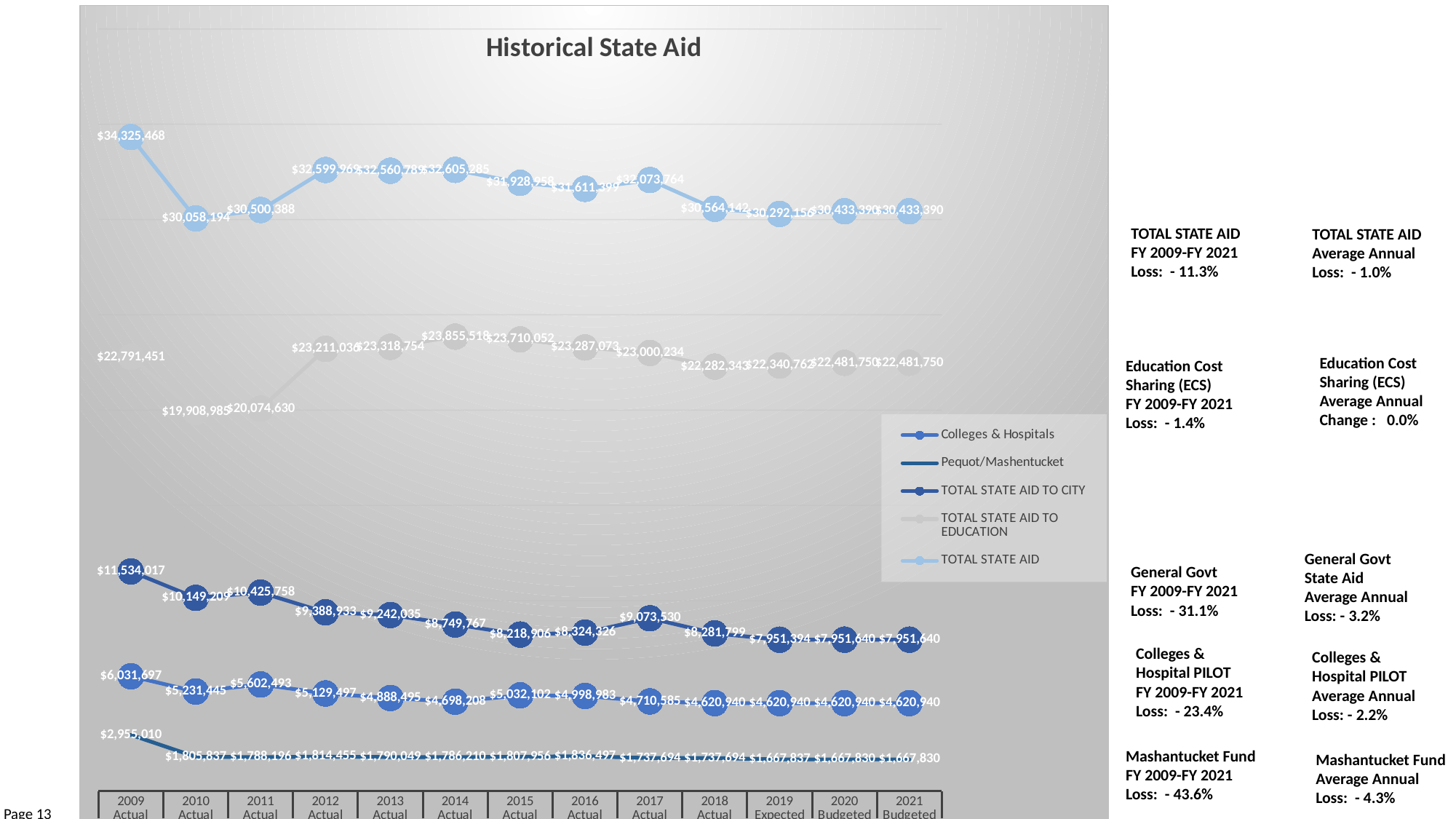
What is the title of the chart? Historical State Aid Which is larger for 2010 Actual: TOTAL STATE AID TO CITY or Colleges & Hospitals? TOTAL STATE AID TO CITY What is the Pequot/Mashentucket value for 2009 Actual? $2,955,010 What is the Colleges & Hospitals value for 2009 Actual? $6,031,697 What is the TOTAL STATE AID TO EDUCATION value for 2014 Actual? $23,855,518 In which year is TOTAL STATE AID TO EDUCATION lowest? 2010 Actual What kind of chart is shown on the slide? Line chart How many years (data points) are shown along the x axis? 13 What is the TOTAL STATE AID value for 2009 Actual? $34,325,468 In which year is TOTAL STATE AID highest? 2009 Actual How many series does the legend list? 5 What is the TOTAL STATE AID TO CITY value for 2021 Budgeted? $7,951,640